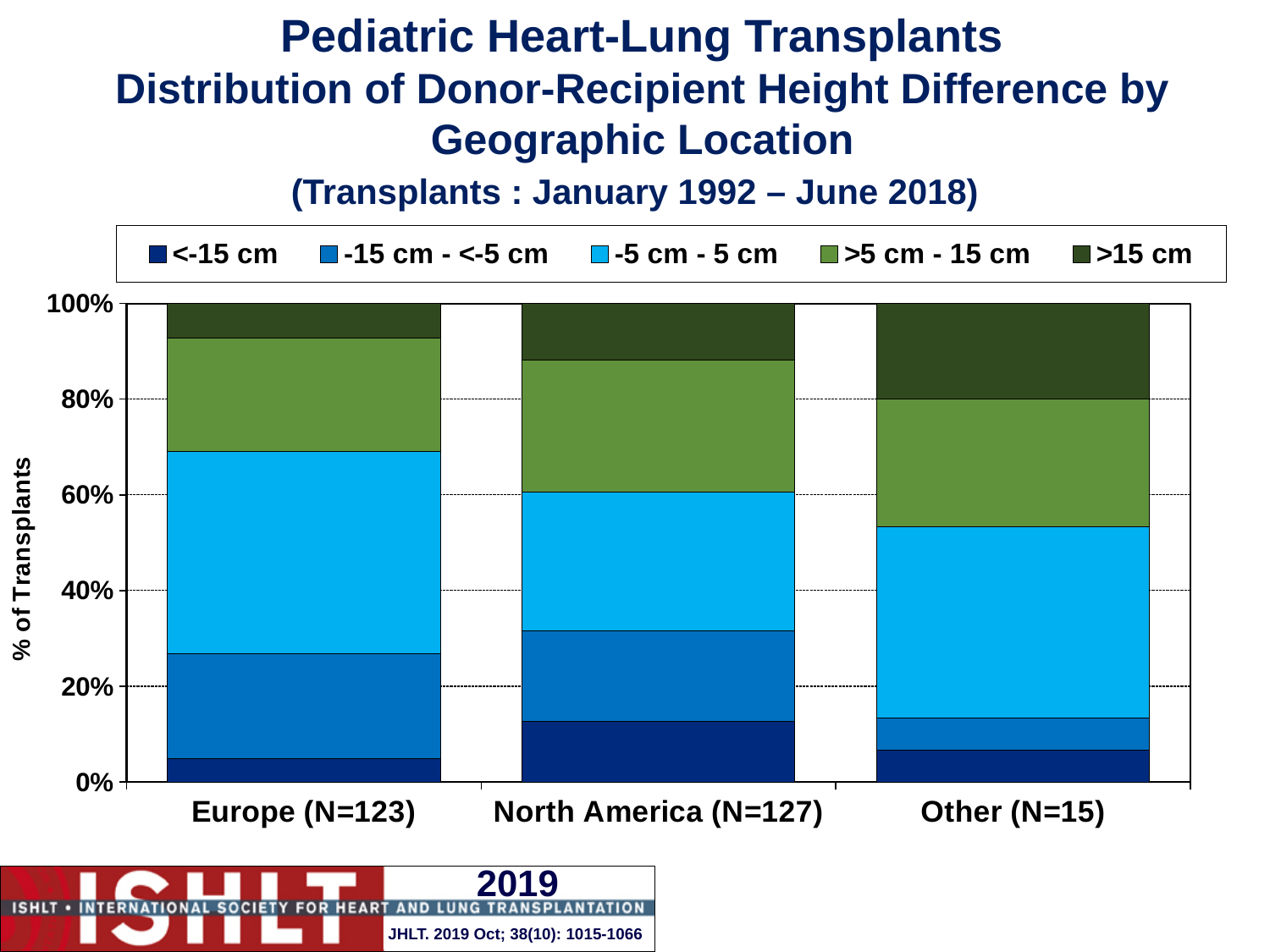
What is the N shown for the Other location? 15 Is the value of the >5 cm - 15 cm segment for Europe (N=123) greater or less than 10%? greater What is the label of the y axis? % of Transplants Is the value of the >15 cm segment for Other (N=15) greater or less than 10%? greater Is the value of the <-15 cm segment for Europe (N=123) greater or less than 20%? less What kind of chart is shown on the slide? Stacked bar chart Which location has the smallest -5 cm - 5 cm segment? North America (N=127) Which location has the largest >15 cm segment? Other (N=15) How many height-difference categories does the legend list? 5 Which has the larger <-15 cm segment, Europe (N=123) or North America (N=127)? North America (N=127) How many geographic locations are shown on the x axis? 3